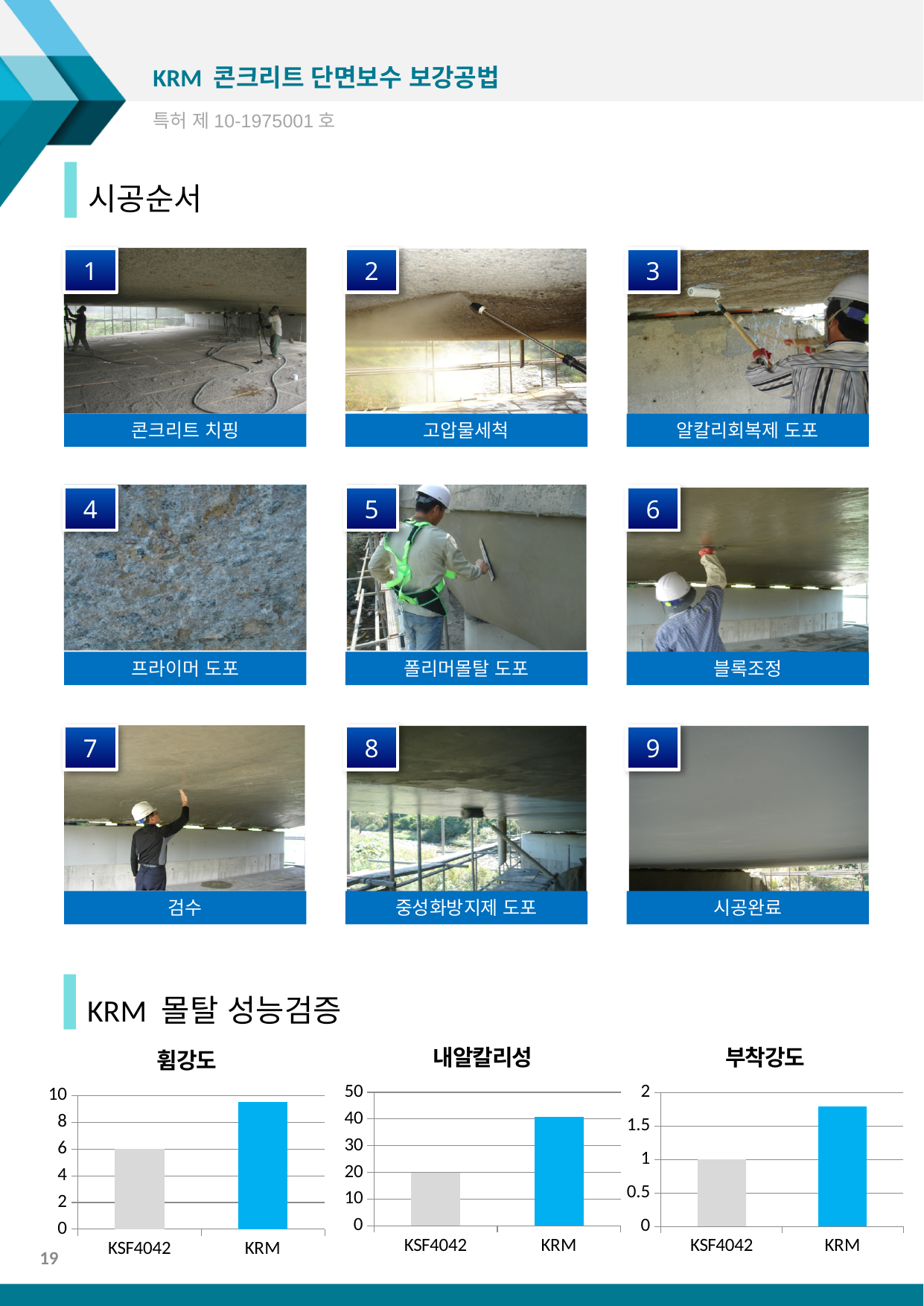
In the 내알칼리성 chart, is the value for KRM greater or less than 30? greater In the 부착강도 chart, is the value for KRM larger or smaller than the value for KSF4042? larger In the 부착강도 chart, what is the value for KSF4042? 1 In the 휨강도 chart, what is the value for KSF4042? 6 In the 내알칼리성 chart, which category has the lower value? KSF4042 What kind of chart is the 휨강도 chart? bar chart In the 부착강도 chart, is the value for KRM greater or less than 1.5? greater In the 내알칼리성 chart, what is the value for KSF4042? 20 In the 휨강도 chart, which category has the higher value? KRM How many bar charts are shown under the heading KRM 몰탈 성능검증? 3 How many categories are shown on the x axis of the 부착강도 chart? 2 In the 휨강도 chart, is the value for KRM greater or less than 8? greater